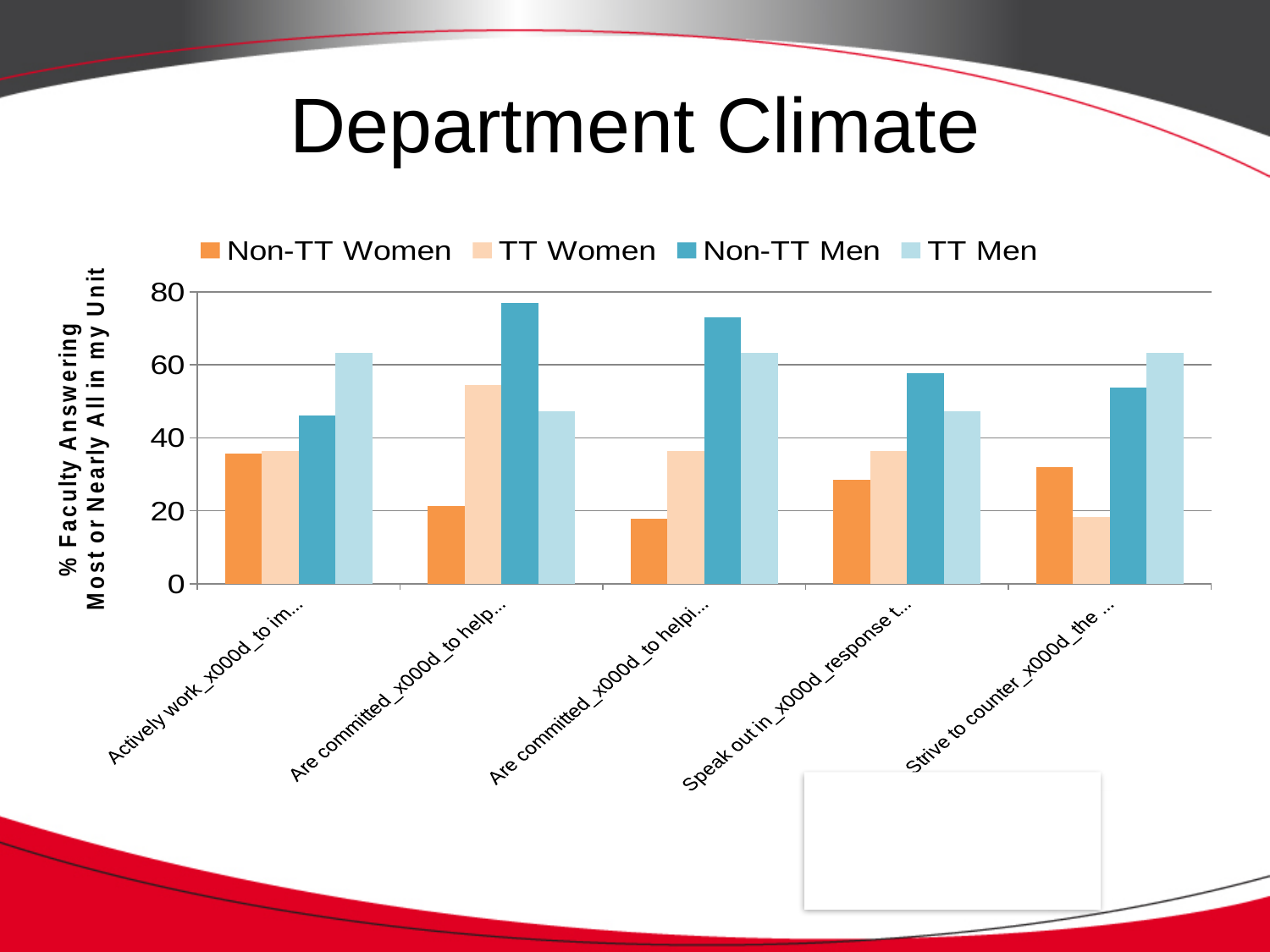
Is the TT Women value for the second category greater or less than 40? greater How many categories are plotted along the x axis? 5 In which category is the TT Women bar the lowest? Strive to counter the ... (fifth category) In the fifth category ("Strive to counter..."), which is larger: Non-TT Women or TT Women? Non-TT Women How many series does the legend list? 4 Is the Non-TT Women value for the third category greater or less than 40? less Which series has the highest value in the third category? Non-TT Men Which series has the lowest value in the second category? Non-TT Women Is the Non-TT Men value for the second category ("Are committed to help...") greater or less than 60? greater What is the title of the slide containing the chart? Department Climate What kind of chart is shown on the slide? bar chart What is the y-axis label of the chart? % Faculty Answering Most or Nearly All in my Unit